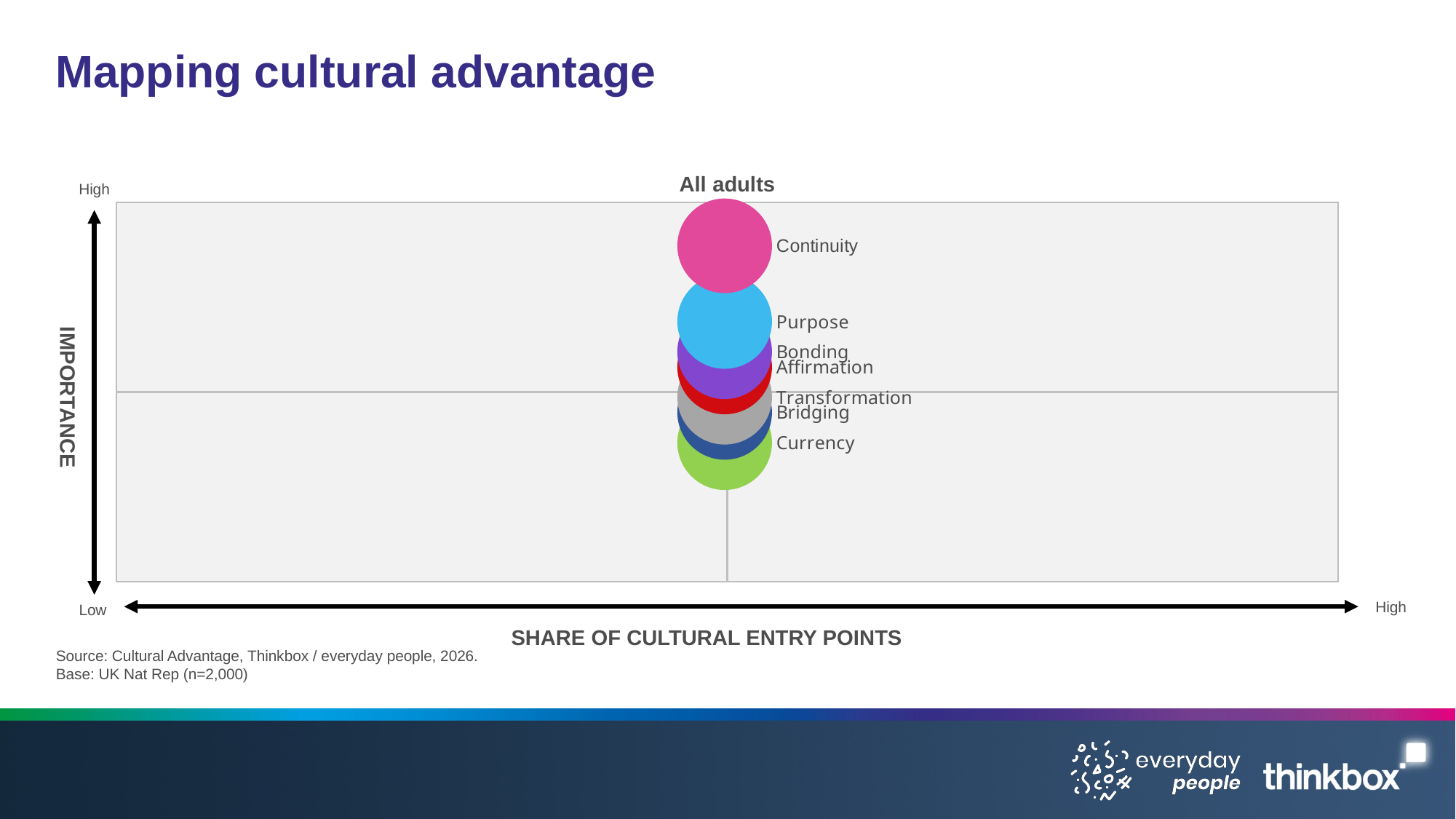
What is the label of the vertical axis of the chart? IMPORTANCE Which is plotted higher on the Importance axis, Currency or Continuity? Continuity Which is plotted higher on the Importance axis, Purpose or Bridging? Purpose Which category is plotted highest on the Importance axis? Continuity Which category is plotted lowest on the Importance axis? Currency How many labelled bubbles are plotted on the chart? 7 What kind of chart is shown on the slide? Bubble chart What is the label of the horizontal axis of the chart? SHARE OF CULTURAL ENTRY POINTS Which is plotted higher on the Importance axis, Bonding or Transformation? Bonding